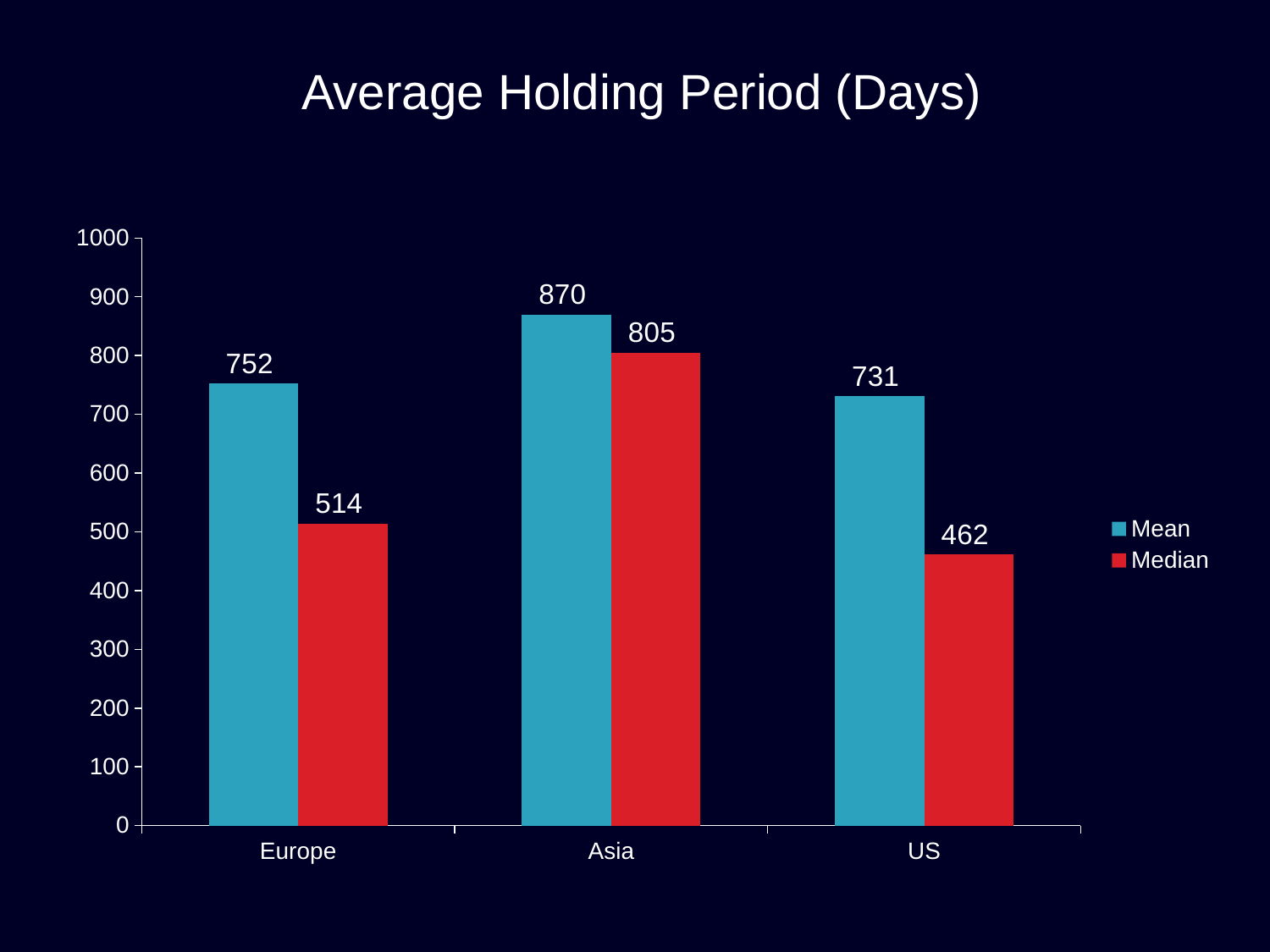
What is the Median holding period for US? 462 Is the Mean holding period for US greater or less than 700? greater Which region has the lowest Median holding period? US How many regions are shown on the x axis? 3 Which is larger, the Median for Europe or the Median for US? Median for Europe What is the difference between the Mean holding periods of Asia and US? 139 What is the difference between the Mean and Median holding periods for Europe? 238 What is the Mean holding period for Europe? 752 What type of chart is shown on the slide? Bar chart What is the Median holding period for Asia? 805 How many series does the legend list? 2 Which region has the highest Mean holding period? Asia